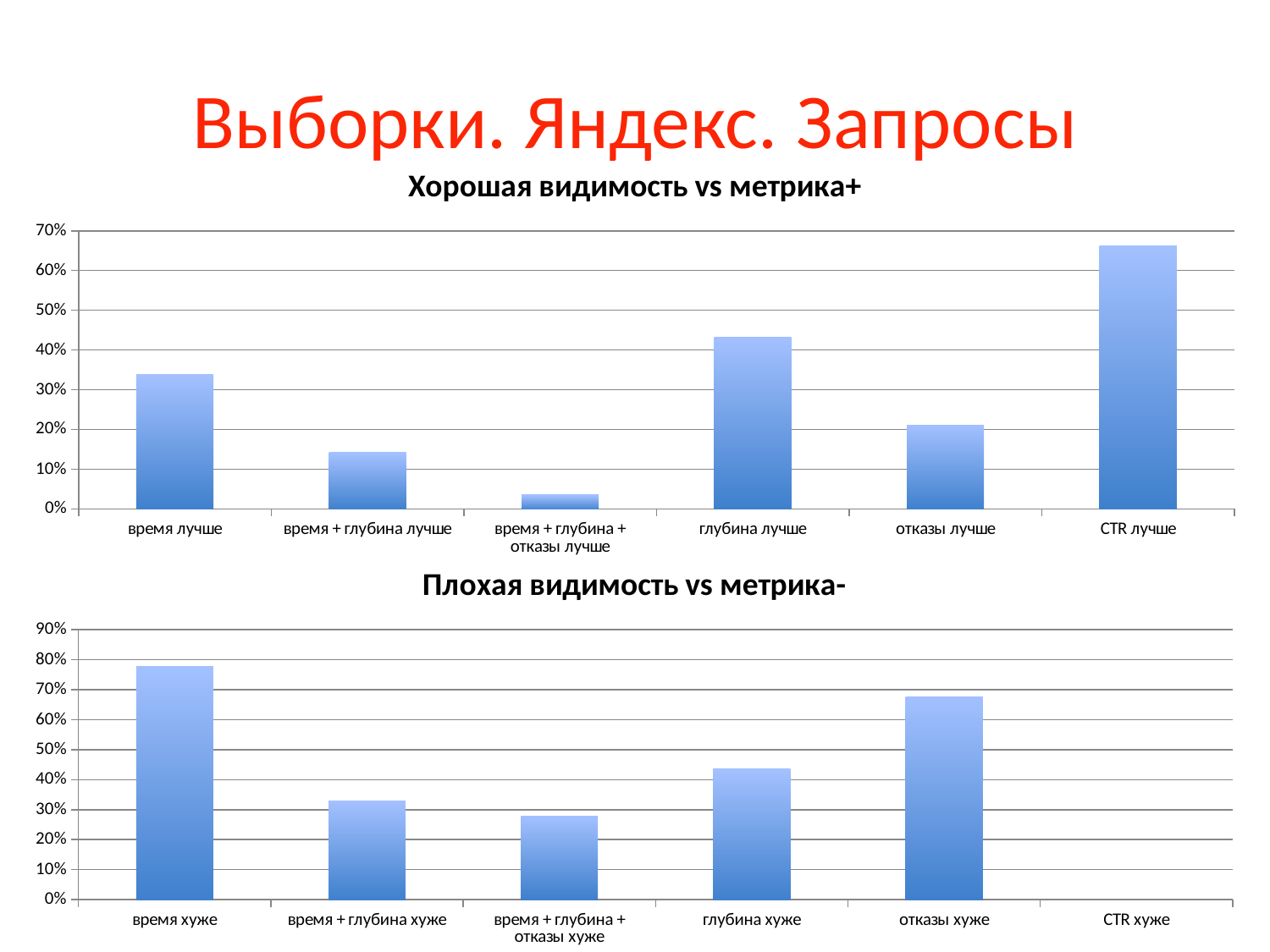
What is the title of the top chart on the slide? Хорошая видимость vs метрика+ In the chart titled "Плохая видимость vs метрика-", which category has the highest value? время хуже In the chart titled "Хорошая видимость vs метрика+", which category has the lowest value? время + глубина + отказы лучше In the chart titled "Хорошая видимость vs метрика+", is the value for "CTR лучше" greater or less than 60%? greater In the chart titled "Хорошая видимость vs метрика+", which is larger: "глубина лучше" or "отказы лучше"? глубина лучше In the chart titled "Хорошая видимость vs метрика+", is the value for "время + глубина лучше" greater or less than 20%? less How many categories are shown on the x axis of the chart titled "Хорошая видимость vs метрика+"? 6 In the chart titled "Хорошая видимость vs метрика+", which category has the highest value? CTR лучше In the chart titled "Плохая видимость vs метрика-", which is larger: "время хуже" or "глубина хуже"? время хуже In the chart titled "Плохая видимость vs метрика-", is the value for "отказы хуже" greater or less than 60%? greater What kind of chart is the chart titled "Плохая видимость vs метрика-"? bar chart